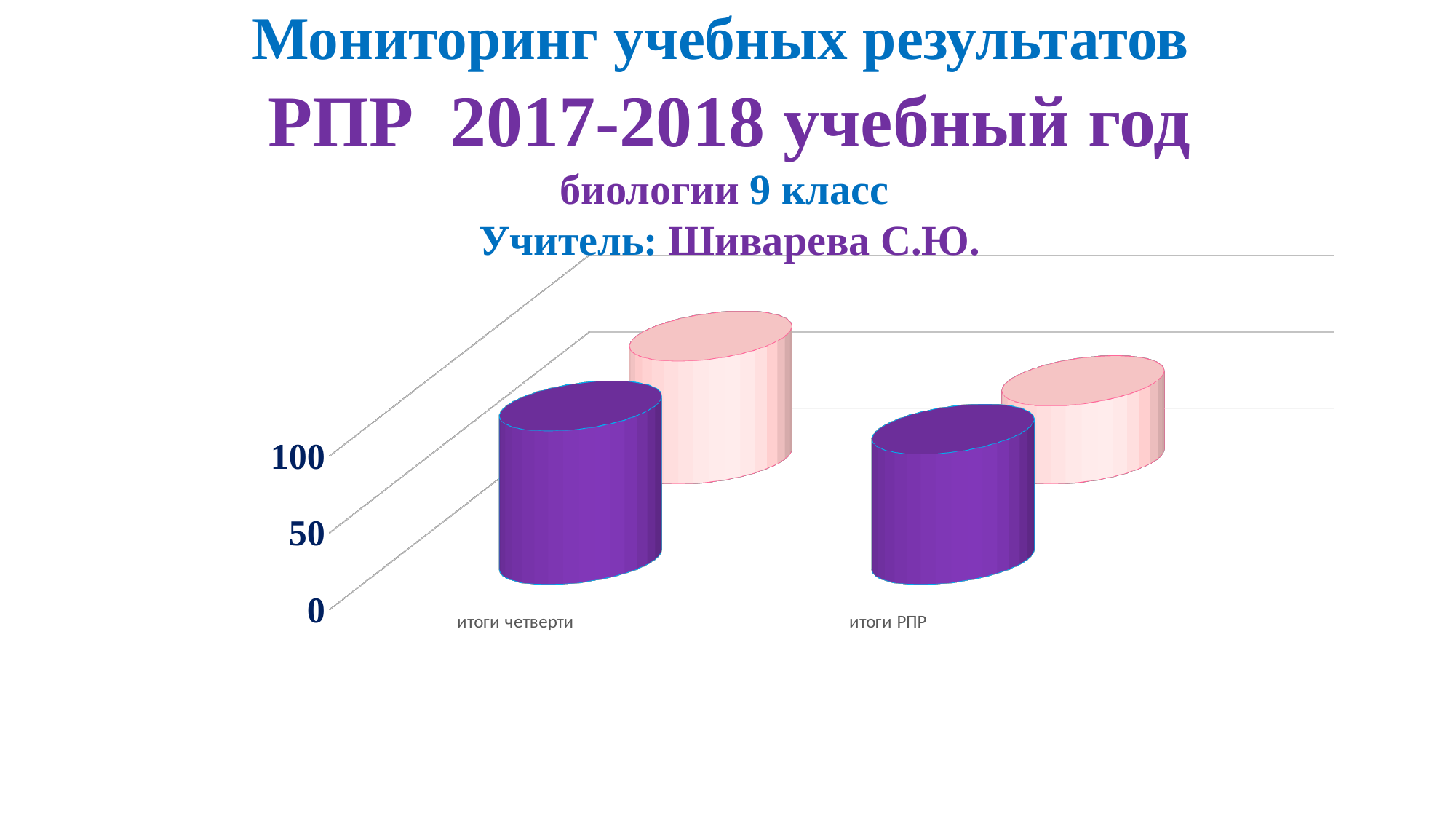
How many categories are shown on the x axis of the chart? 2 For итоги РПР, which bar is larger, the purple one or the pink one? purple Is the value of the pink bar for итоги РПР greater or less than 100? less What kind of chart is shown on the slide? bar chart Is the value of the purple bar for итоги РПР greater or less than 50? greater What are the two category labels on the x axis of the chart? итоги четверти, итоги РПР For the pink series, which category has the higher value, итоги четверти or итоги РПР? итоги четверти What is the highest tick value shown on the vertical axis of the chart? 100 How many data series (bar colours) are plotted in the chart? 2 Do the values of the pink series rise or fall from итоги четверти to итоги РПР? fall Is the value of the purple bar for итоги четверти greater or less than 50? greater